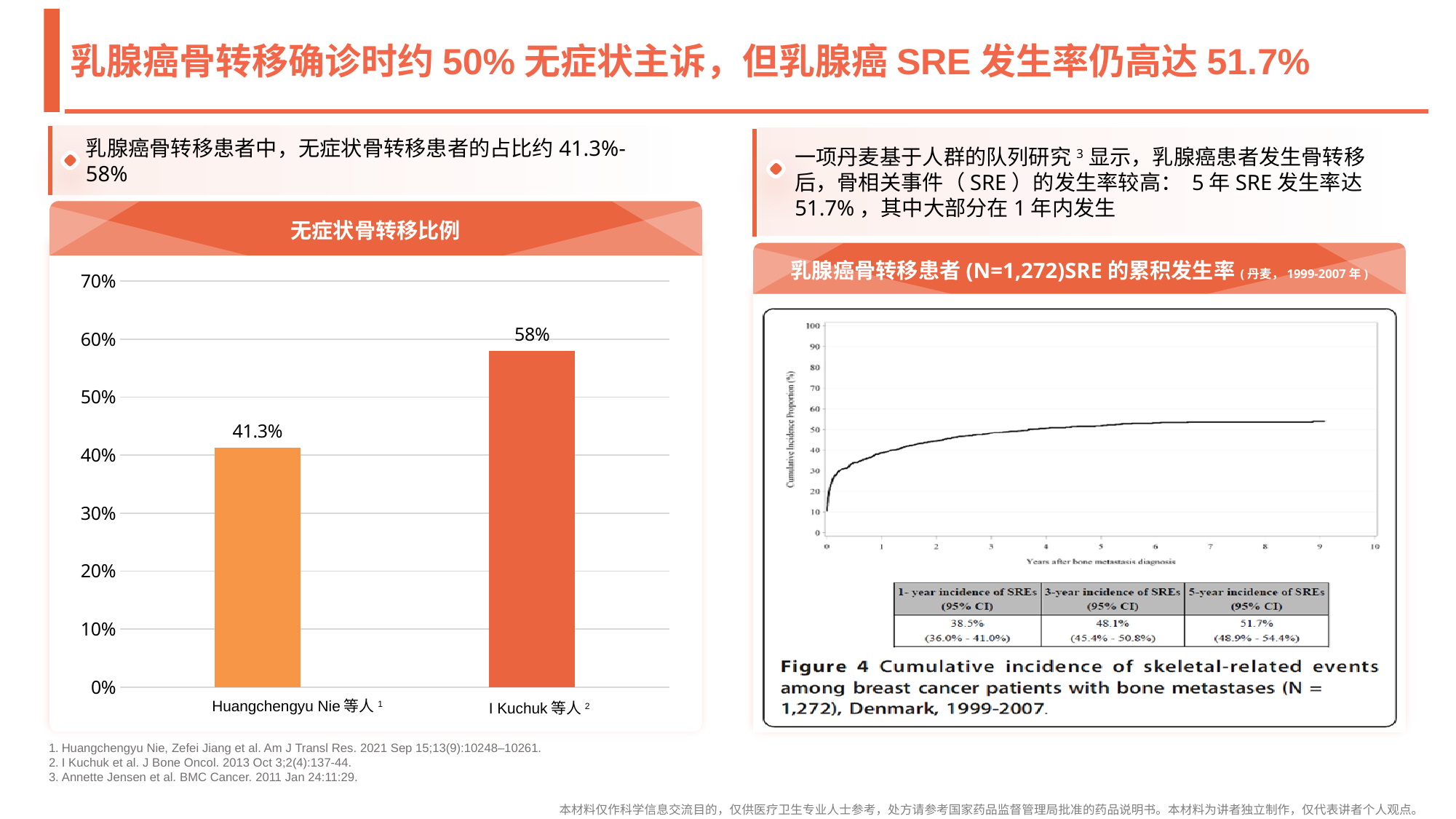
In the chart on the right (cumulative incidence of SREs), what is the 5-year incidence of SREs shown in the table? 51.7% In the bar chart titled 无症状骨转移比例, which category has the highest value? I Kuchuk 等人 In the bar chart titled 无症状骨转移比例, what is the difference between the values for I Kuchuk 等人 and Huangchengyu Nie 等人? 16.7% In the chart on the right (cumulative incidence of SREs), what is the 1-year incidence of SREs shown in the table? 38.5% In the chart on the right (cumulative incidence of SREs), what is the difference between the 5-year and 3-year incidence of SREs shown in the table? 3.6% In the bar chart titled 无症状骨转移比例, which category has the lowest value? Huangchengyu Nie 等人 In the bar chart titled 无症状骨转移比例, how many categories are shown? 2 In the bar chart titled 无症状骨转移比例, what is the value for I Kuchuk 等人? 58% What kind of chart is the chart titled 无症状骨转移比例? Bar chart In the bar chart titled 无症状骨转移比例, what is the value for Huangchengyu Nie 等人? 41.3% In the chart on the right (cumulative incidence of SREs), does the cumulative incidence rise or fall as years after bone metastasis diagnosis increase? Rise In the bar chart titled 无症状骨转移比例, is the value for Huangchengyu Nie 等人 greater or less than 50%? less